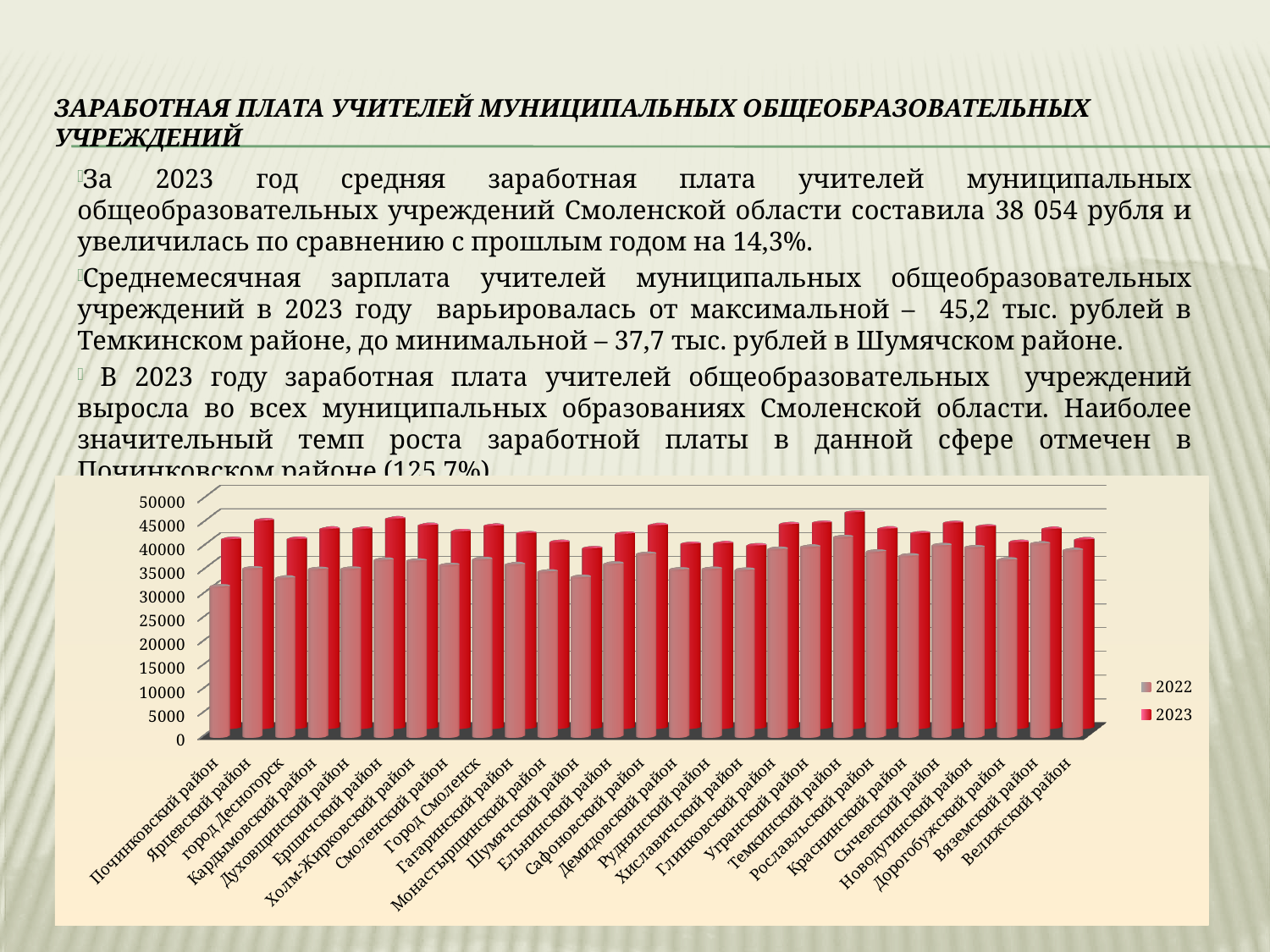
Is the 2023 value for Шумячский район greater or less than 40000? less How many municipal districts (categories) are shown on the x axis of the chart? 27 How many series does the chart legend list? 2 What kind of chart is shown on the slide? bar chart Which is larger: the 2022 value for Темкинский район or the 2022 value for Починковский район? Темкинский район Which district has the lowest 2022 bar in the chart? Починковский район Is the 2023 value for Ярцевский район greater or less than 40000? greater For Починковский район, which is larger: the 2022 value or the 2023 value? 2023 Is the 2023 value for Темкинский район greater or less than 40000? greater Which district has the highest 2023 bar in the chart? Темкинский район Which years are listed in the chart legend? 2022 and 2023